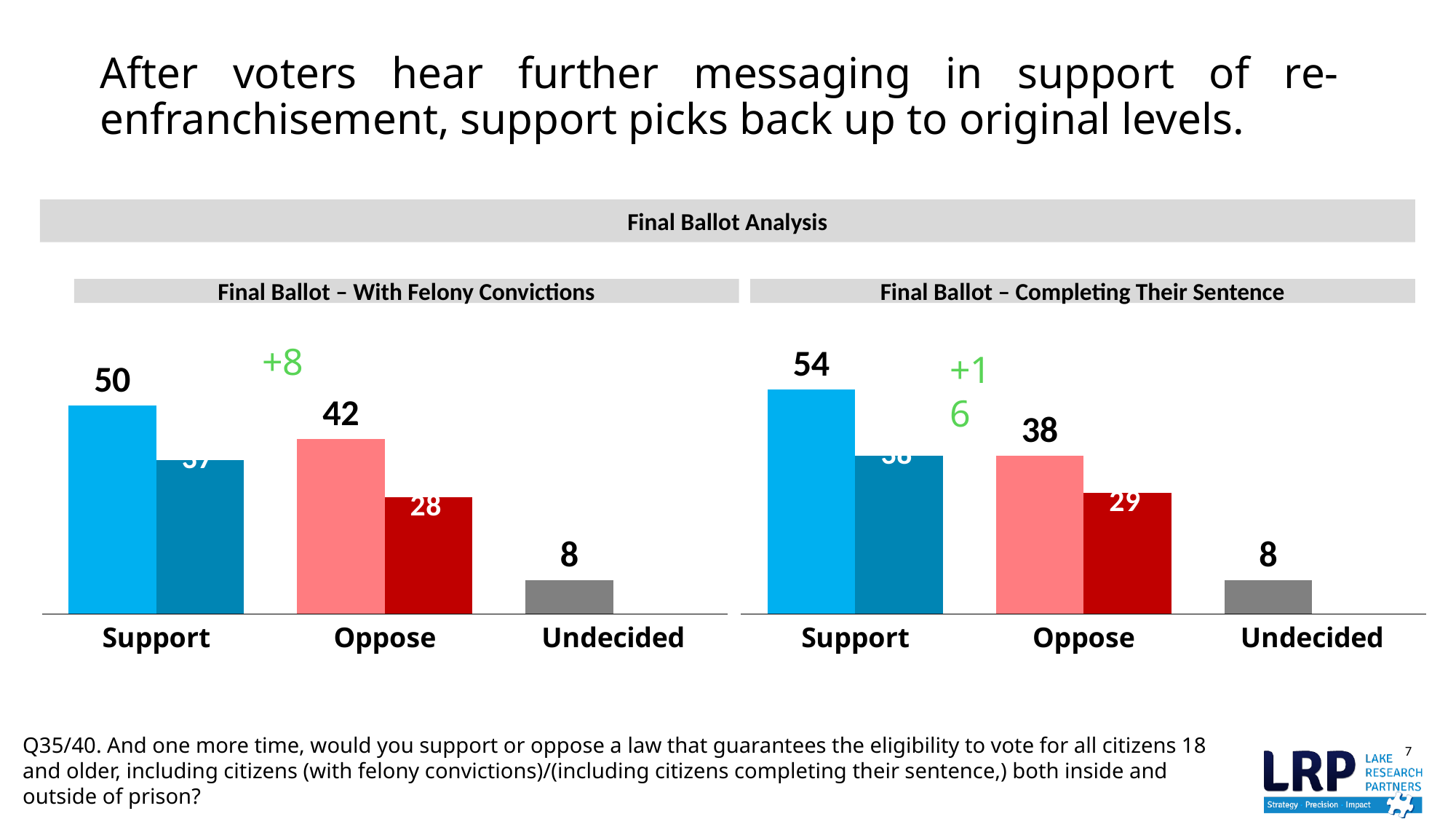
How many categories are shown on the x axis of the 'Final Ballot – Completing Their Sentence' chart? 3 In the 'Final Ballot – With Felony Convictions' chart, what is the value of the light blue Support bar? 50 In the 'Final Ballot – With Felony Convictions' chart, what is the value for Undecided? 8 In the 'Final Ballot – With Felony Convictions' chart, what is the difference between the light blue Support bar and the pink Oppose bar? 8 In the 'Final Ballot – With Felony Convictions' chart, what is the value of the pink Oppose bar? 42 In the 'Final Ballot – Completing Their Sentence' chart, what is the difference between the light blue Support bar and the pink Oppose bar? 16 In the 'Final Ballot – With Felony Convictions' chart, which category has the lowest value? Undecided In the 'Final Ballot – Completing Their Sentence' chart, what is the value of the dark red Oppose bar? 29 In the 'Final Ballot – Completing Their Sentence' chart, what is the value of the light blue Support bar? 54 In the 'Final Ballot – Completing Their Sentence' chart, what is the value of the pink Oppose bar? 38 In the 'Final Ballot – With Felony Convictions' chart, what is the value of the dark red Oppose bar? 28 What type of chart is the 'Final Ballot – With Felony Convictions' chart? Bar chart